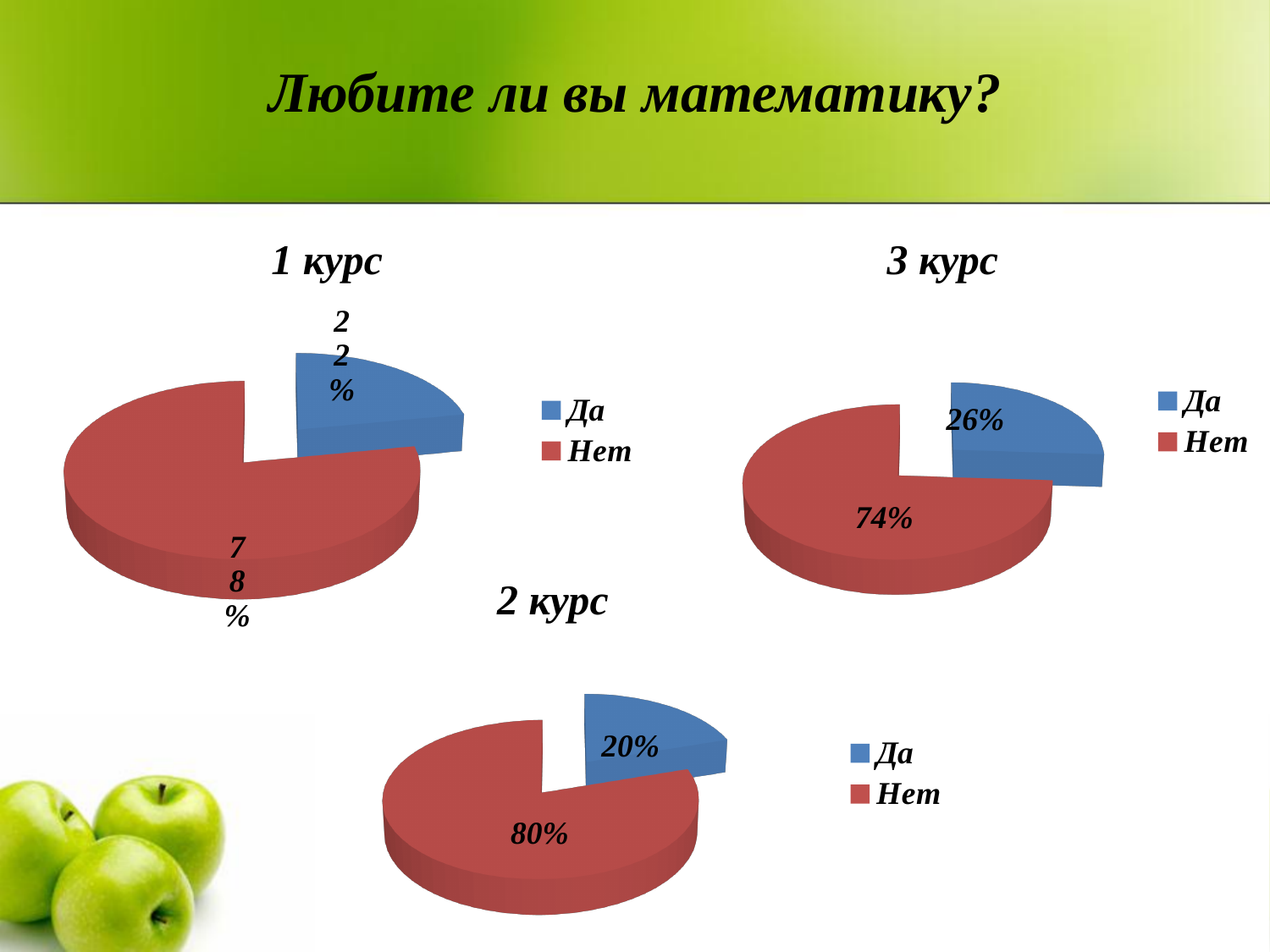
What kind of chart is the "2 курс" chart? Pie chart In the "2 курс" chart, what is the value for "Нет"? 80% In the "1 курс" chart, what is the difference between the "Нет" and "Да" shares? 56% How many series does the legend of the "3 курс" chart list? 2 In the "3 курс" chart, what is the value for "Да"? 26% In the "3 курс" chart, which slice is the smallest? Да In the "3 курс" chart, what is the value for "Нет"? 74% In the "1 курс" chart, what share of the pie is labelled "Нет"? 78% In the "2 курс" chart, what is the value for "Да"? 20% In the "1 курс" chart, what share of the pie is labelled "Да"? 22% In the "2 курс" chart, which slice is the largest? Нет Which is larger: the "Да" share in the "3 курс" chart or the "Да" share in the "2 курс" chart? 3 курс